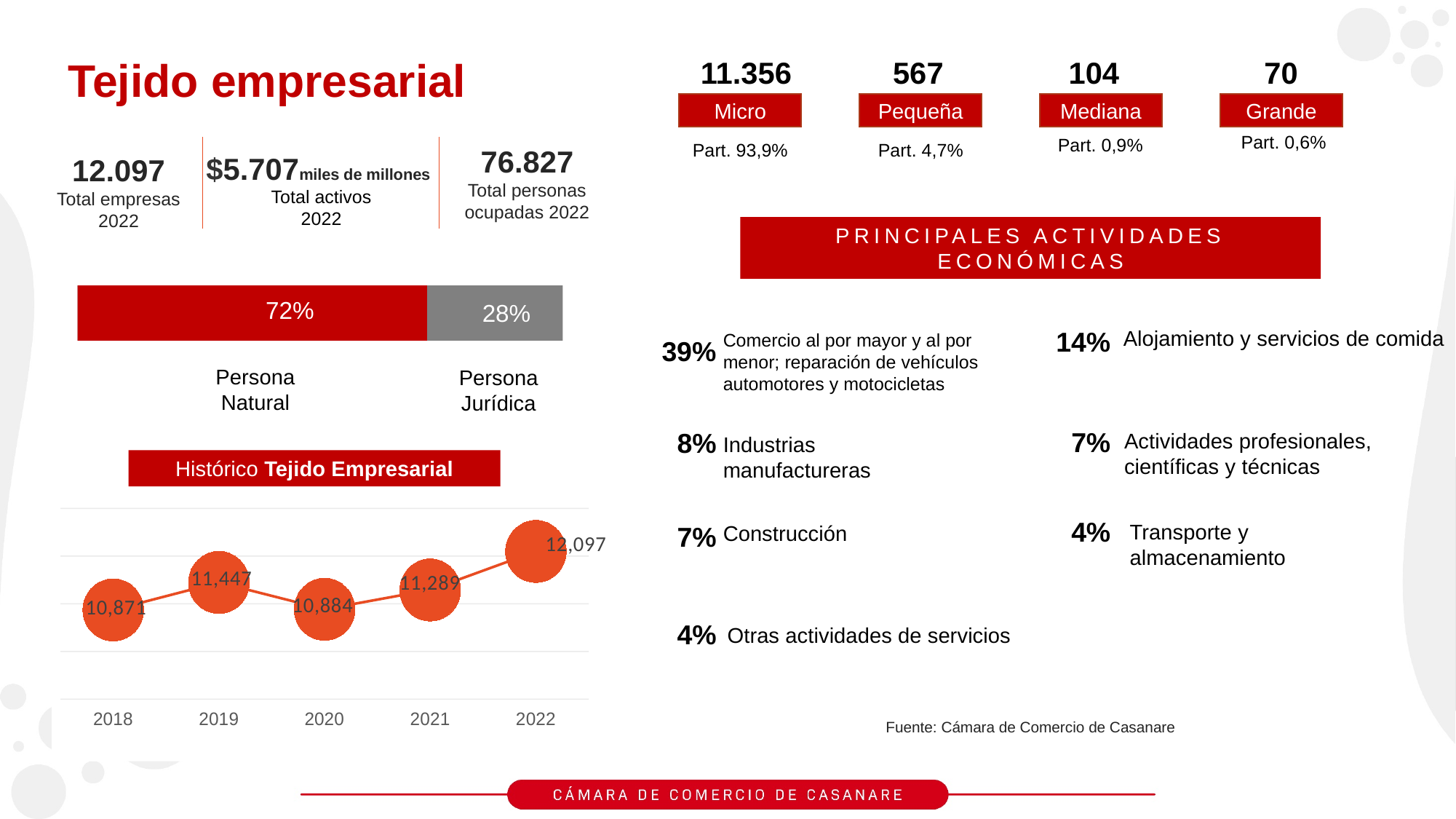
In the 'Histórico Tejido Empresarial' chart, does the value rise or fall from 2021 to 2022? Rise In the 'Histórico Tejido Empresarial' chart, which year has the lowest value? 2018 In the Persona Natural / Persona Jurídica bar, what share is Persona Natural? 72% In the 'Histórico Tejido Empresarial' chart, what is the value for 2022? 12,097 In the 'Histórico Tejido Empresarial' chart, what is the value for 2020? 10,884 In the 'Histórico Tejido Empresarial' chart, what is the value for 2018? 10,871 In the 'Histórico Tejido Empresarial' chart, what is the difference between the 2022 value and the 2021 value? 808 In the Persona Natural / Persona Jurídica bar, what is the difference between the Persona Natural share and the Persona Jurídica share? 44% In the 'Histórico Tejido Empresarial' chart, which is larger, the value for 2019 or the value for 2021? 2019 How many years are plotted in the 'Histórico Tejido Empresarial' chart? 5 What kind of chart is the 'Histórico Tejido Empresarial' chart? Line chart In the 'Histórico Tejido Empresarial' chart, which year has the highest value? 2022